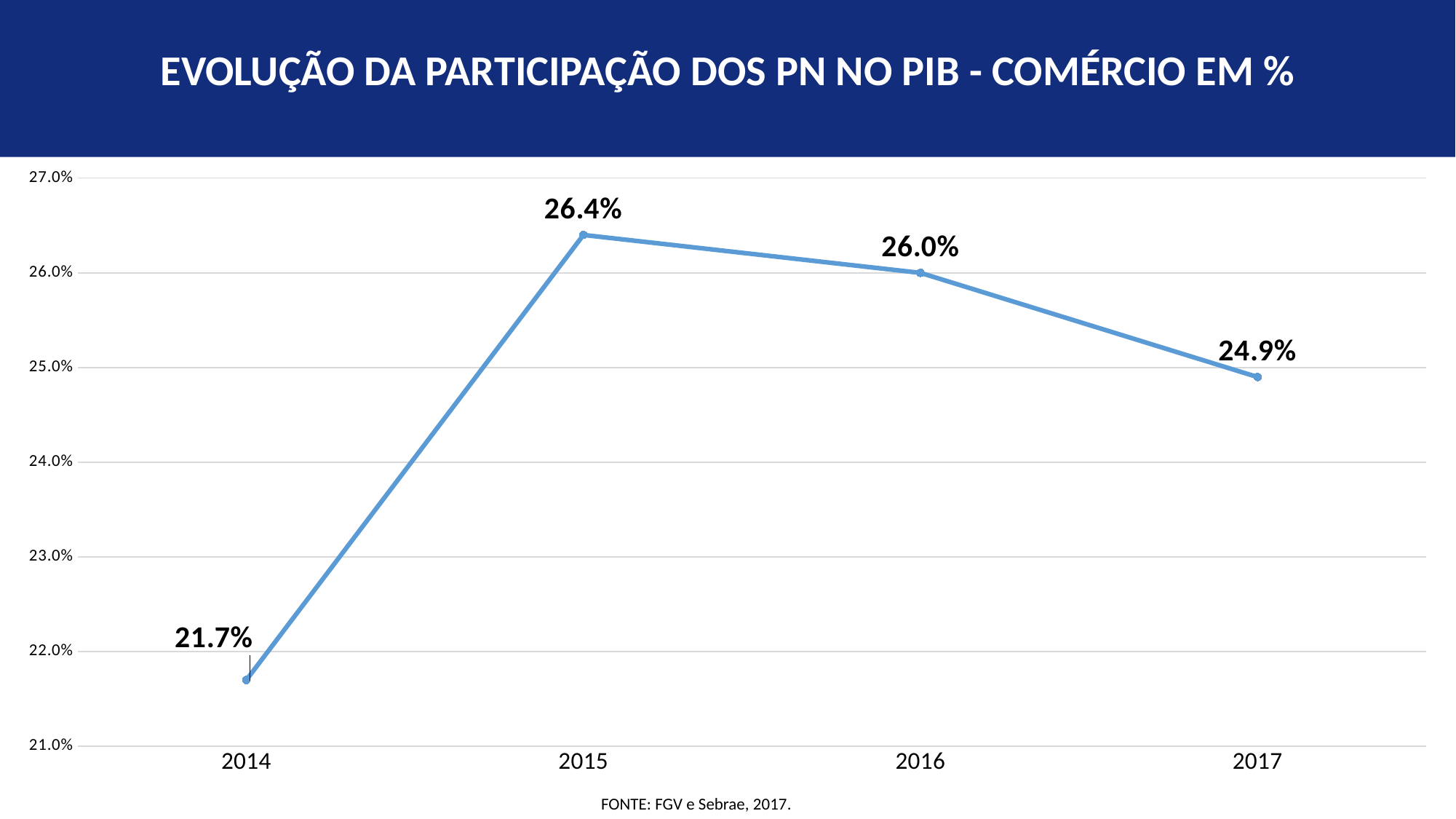
What kind of chart is shown on the slide? Line chart What is the value for 2014? 21.7% What is the value for 2017? 24.9% Which year has the lowest value? 2014 What is the value for 2016? 26.0% What is the difference between the values for 2016 and 2017? 1.1% Which is larger, the value for 2016 or the value for 2017? 2016 Which year has the highest value? 2015 What is the difference between the values for 2015 and 2014? 4.7% Does the value rise or fall from 2015 to 2017? Fall What is the value for 2015? 26.4% How many years are plotted on the chart? 4